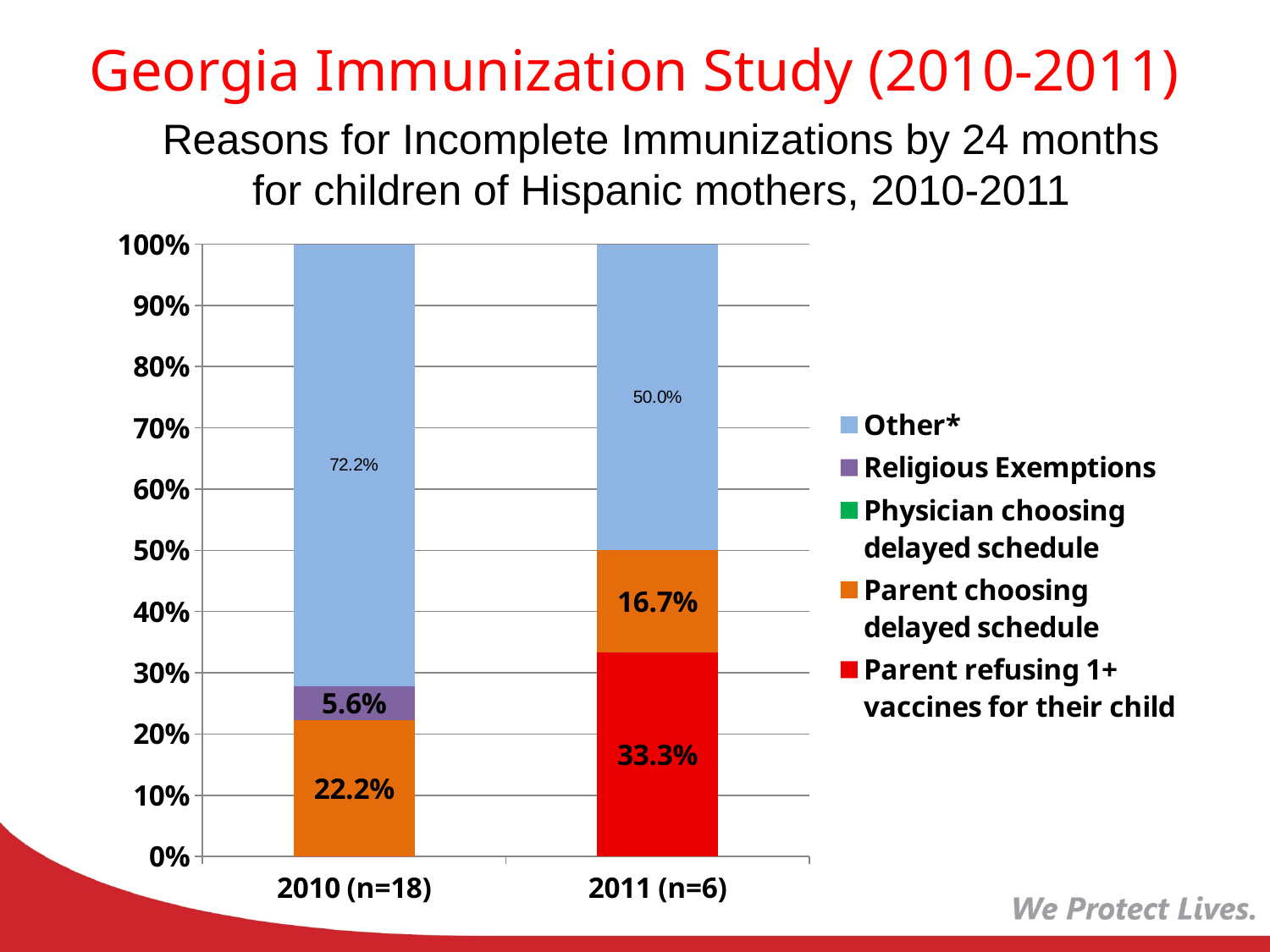
What is the value for Other* in the 2010 (n=18) bar? 72.2% What kind of chart is shown on the slide? Stacked bar chart How many bars (year categories) are plotted on the x axis? 2 What is the value for Religious Exemptions in the 2010 (n=18) bar? 5.6% Which segment is the smallest in the 2010 (n=18) bar? Religious Exemptions What is the value for Parent refusing 1+ vaccines for their child in the 2011 (n=6) bar? 33.3% What is the difference between the Other* value in 2010 (n=18) and in 2011 (n=6)? 22.2% What is the value for Other* in the 2011 (n=6) bar? 50.0% Which is larger: Parent choosing delayed schedule in 2010 (n=18) or in 2011 (n=6)? 2010 (n=18) What is the value for Parent choosing delayed schedule in the 2010 (n=18) bar? 22.2% Which segment is the largest in the 2011 (n=6) bar? Other* How many series does the legend list? 5